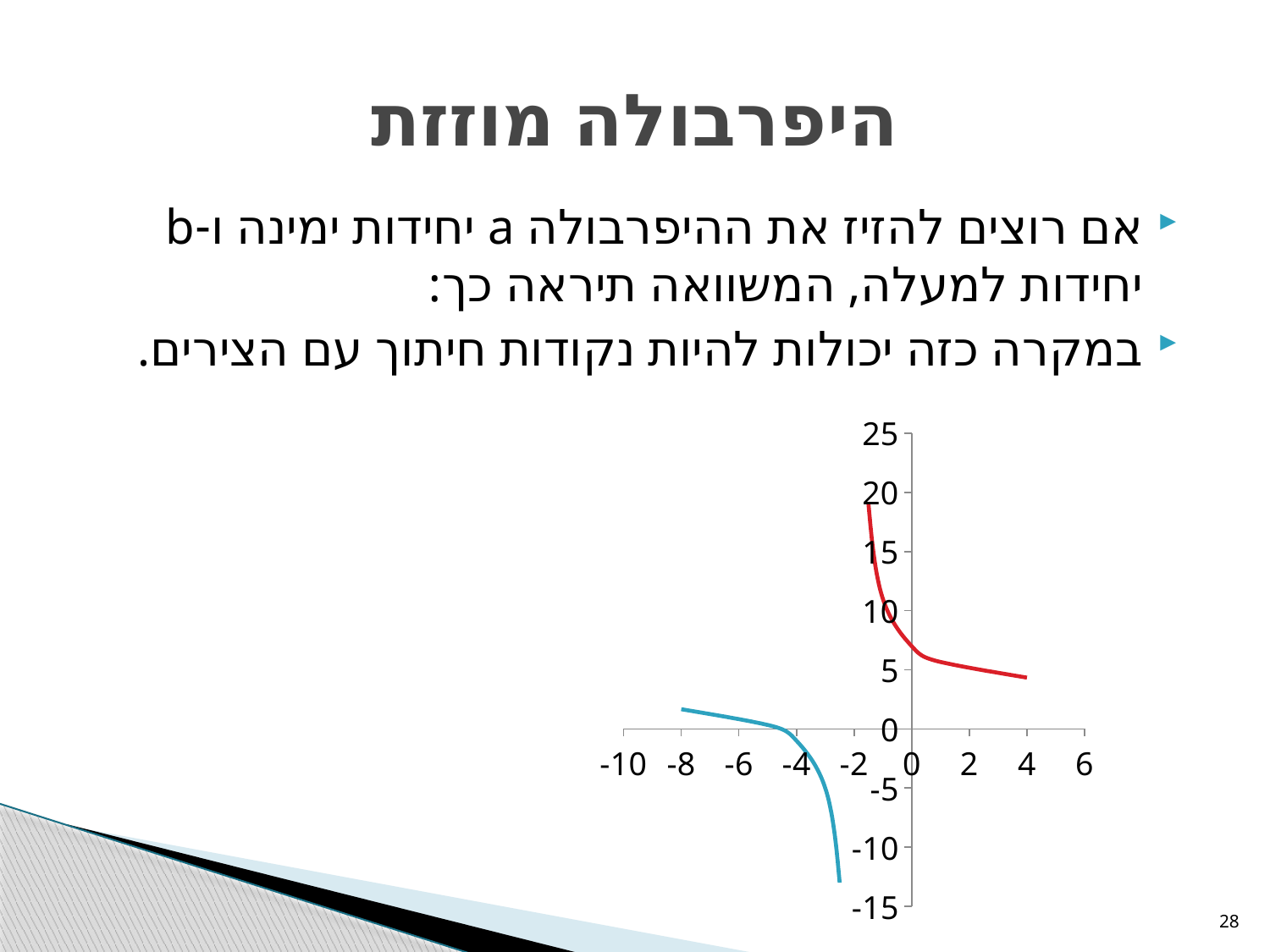
What kind of chart is shown on the slide? line chart What is the highest value labelled on the vertical axis? 25 Along the red curve, do the values rise or fall as x increases? fall How many curves (branches) are plotted on the chart? 2 Along the blue curve, do the values rise or fall as x increases? fall Which curve reaches higher values, the red curve or the blue curve? red curve What colour is the curve in the upper-right part of the chart? red Is the value of the blue curve at x = -3 greater or less than 0? less Is the value of the red curve at x = 4 greater or less than 10? less What colour is the curve in the lower-left part of the chart? blue Is the value of the red curve at x = 4 greater or less than 0? greater